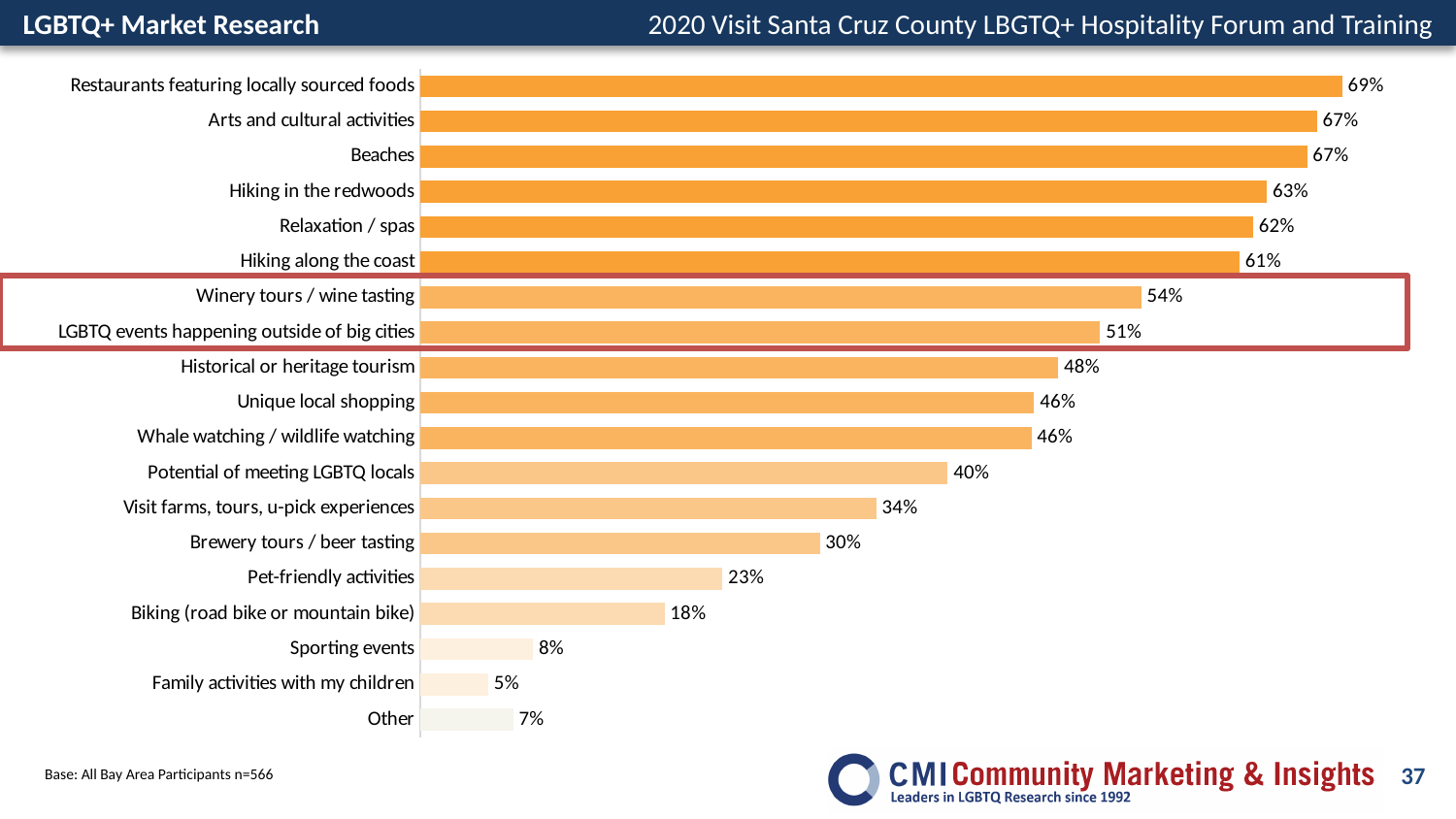
Which category has the highest value? Restaurants featuring locally sourced foods Which category has the lowest value? Family activities with my children How many categories are shown in the chart? 19 Which two categories are outlined with a red box? Winery tours / wine tasting and LGBTQ events happening outside of big cities What is the value for Winery tours / wine tasting? 54% What is the value for Brewery tours / beer tasting? 30% What kind of chart is shown on the slide? Bar chart What percentage is shown for LGBTQ events happening outside of big cities? 51% What percentage is shown for Restaurants featuring locally sourced foods? 69% What is the difference between Winery tours / wine tasting and Brewery tours / beer tasting? 24% What is the difference between Hiking in the redwoods and Hiking along the coast? 2%